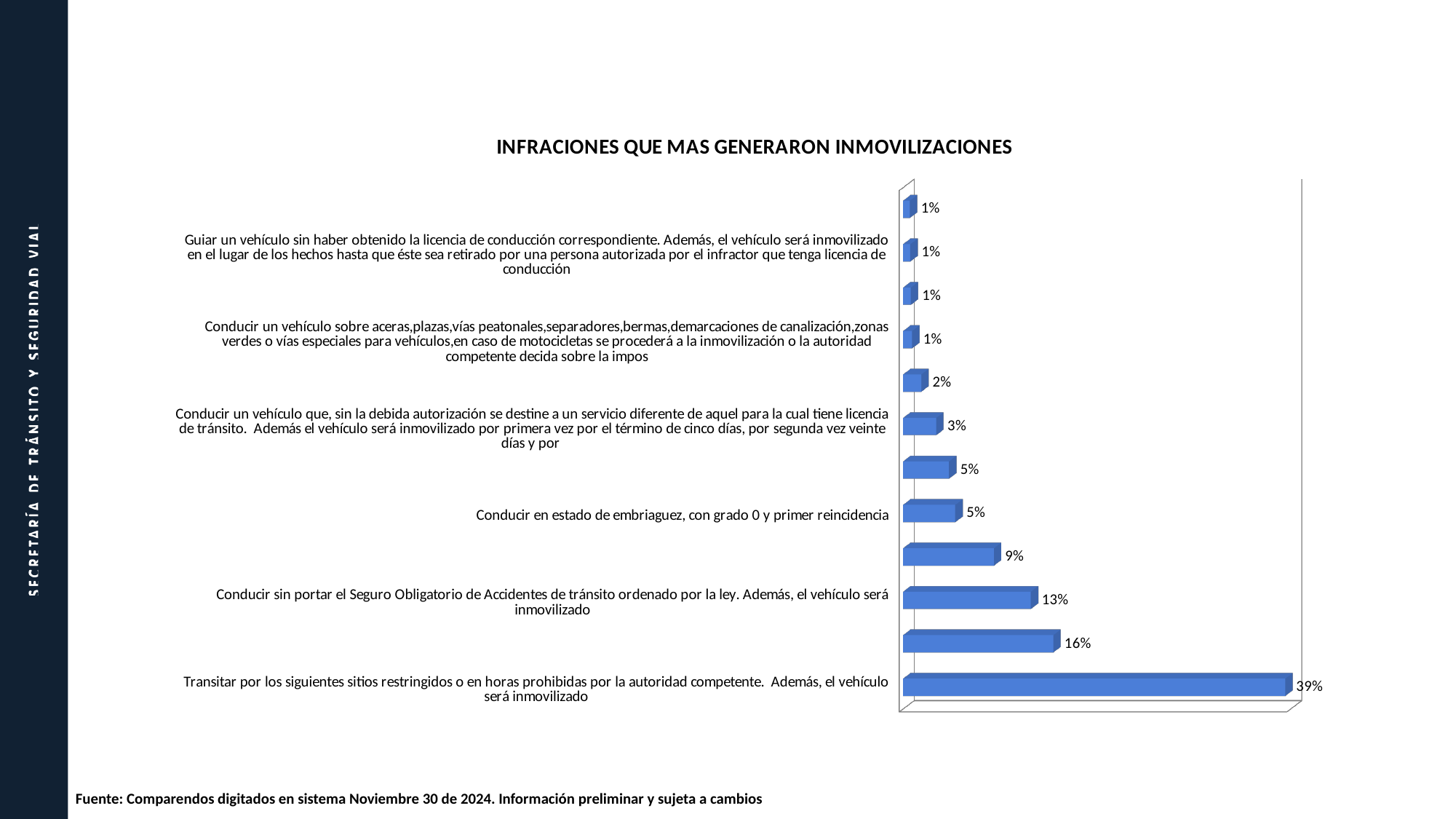
What is the difference between the percentage for 'Transitar por los siguientes sitios restringidos...' and 'Conducir sin portar el Seguro Obligatorio...'? 26% What is the title of the chart? INFRACIONES QUE MAS GENERARON INMOVILIZACIONES Which has a larger percentage: 'Conducir sin portar el Seguro Obligatorio...' or 'Conducir en estado de embriaguez, con grado 0 y primer reincidencia'? Conducir sin portar el Seguro Obligatorio de Accidentes de tránsito ordenado por la ley. Además, el vehículo será inmovilizado What type of chart is shown on the slide? bar chart Which infraction has the highest percentage in the chart? Transitar por los siguientes sitios restringidos o en horas prohibidas por la autoridad competente. Además, el vehículo será inmovilizado What percentage is shown for 'Conducir en estado de embriaguez, con grado 0 y primer reincidencia'? 5% What percentage is shown for 'Conducir sin portar el Seguro Obligatorio de Accidentes de tránsito ordenado por la ley'? 13% What percentage is shown for 'Guiar un vehículo sin haber obtenido la licencia de conducción correspondiente'? 1% What is the lowest percentage value shown on any bar in the chart? 1% How many bars are plotted in the chart? 12 What percentage is shown for 'Transitar por los siguientes sitios restringidos o en horas prohibidas por la autoridad competente'? 39% What percentage is shown for 'Conducir un vehículo que, sin la debida autorización se destine a un servicio diferente de aquel para la cual tiene licencia de tránsito'? 3%